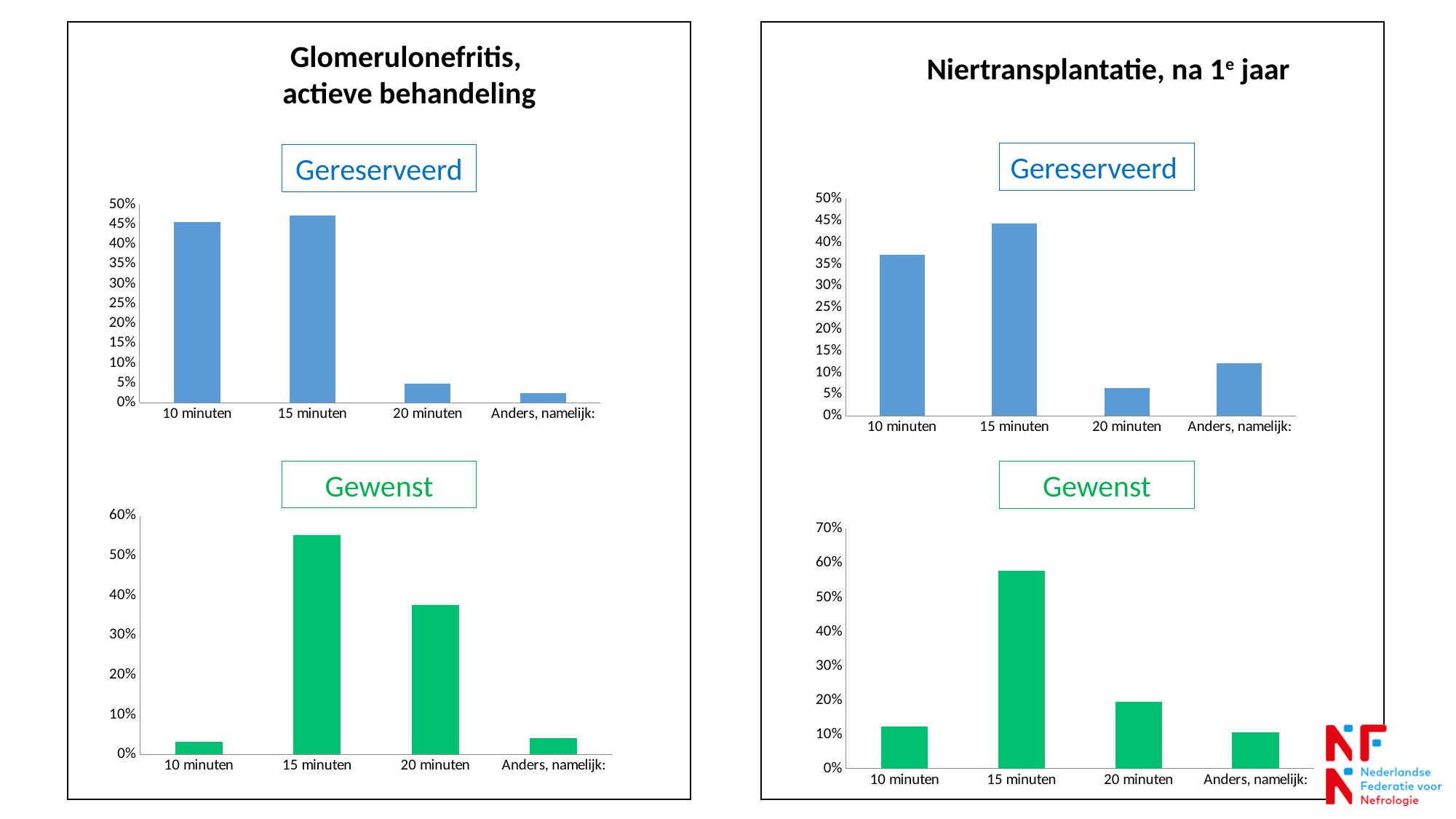
In the 'Gewenst' chart under 'Glomerulonefritis, actieve behandeling', is the value for 20 minuten greater or less than 30%? greater In the 'Gewenst' chart under 'Glomerulonefritis, actieve behandeling', which category has the highest value? 15 minuten What kind of chart is the 'Gereserveerd' chart under 'Glomerulonefritis, actieve behandeling'? bar chart In the 'Gereserveerd' chart under 'Niertransplantatie, na 1e jaar', which category has the lowest value? 20 minuten In the 'Gereserveerd' chart under 'Glomerulonefritis, actieve behandeling', is the value for 10 minuten greater or less than 40%? greater In the 'Gereserveerd' chart under 'Niertransplantatie, na 1e jaar', which category has the highest value? 15 minuten In the 'Gewenst' chart under 'Niertransplantatie, na 1e jaar', which is larger: the value for 20 minuten or the value for 10 minuten? 20 minuten In the 'Gereserveerd' chart under 'Glomerulonefritis, actieve behandeling', which category has the lowest value? Anders, namelijk: How many categories are shown on the x axis of the 'Gewenst' chart under 'Niertransplantatie, na 1e jaar'? 4 In the 'Gereserveerd' chart under 'Glomerulonefritis, actieve behandeling', is the value for 20 minuten greater or less than 10%? less